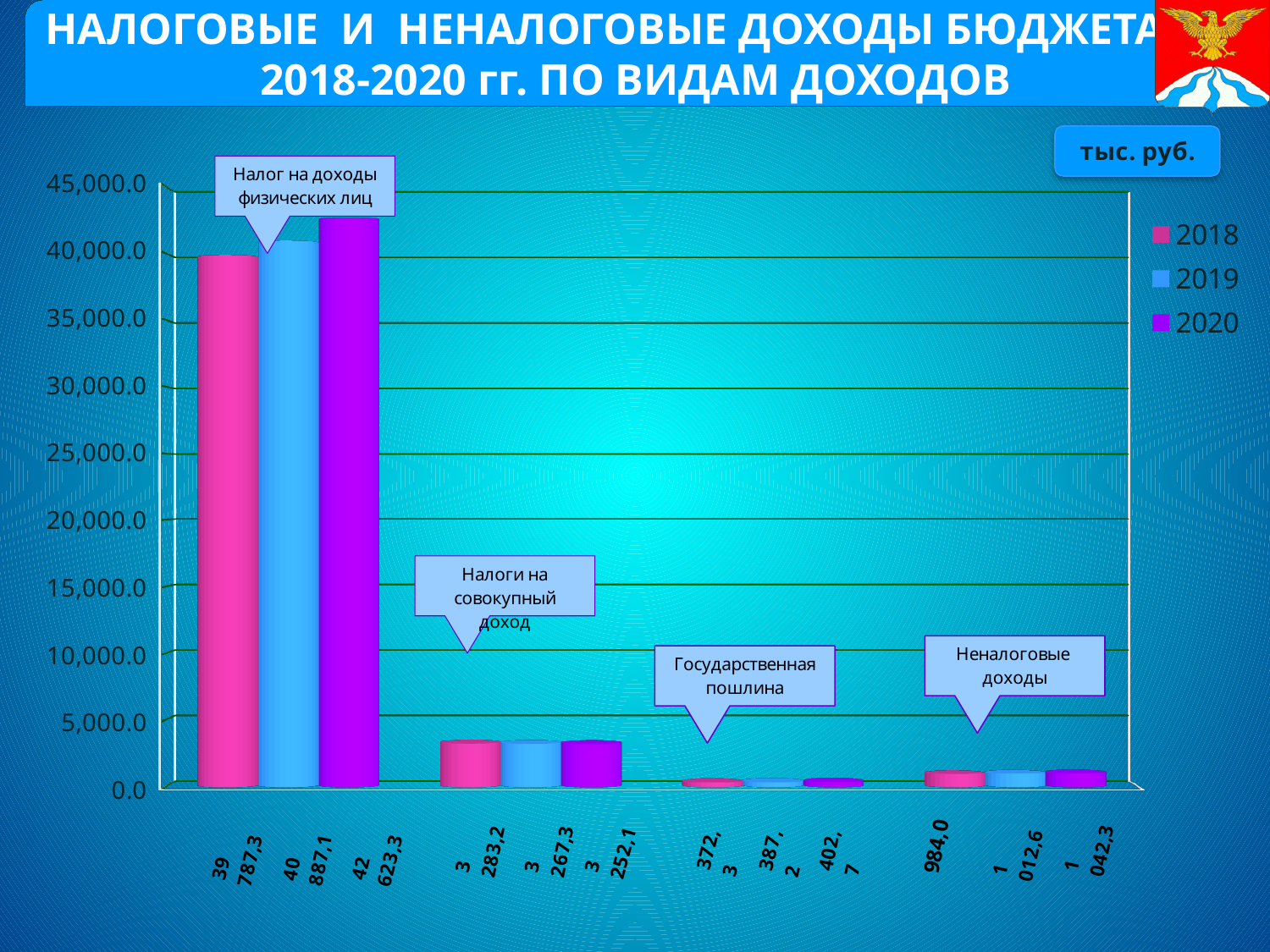
What is the value for Неналоговые доходы in 2020? 1 042,3 What unit of measurement is indicated on the slide? тыс. руб. How many series does the legend list? 3 What is the value for Налог на доходы физических лиц in 2018? 39 787,3 What kind of chart is shown on the slide? bar chart What is the value for Налог на доходы физических лиц in 2020? 42 623,3 What is the value for Государственная пошлина in 2019? 387,2 Do the values for Налог на доходы физических лиц rise or fall from 2018 to 2020? rise Is the value for Налог на доходы физических лиц in 2020 greater or less than 40,000.0? greater Which category has the lowest values in the chart? Государственная пошлина Which category has the highest values in the chart? Налог на доходы физических лиц How many income categories are shown in the chart? 4